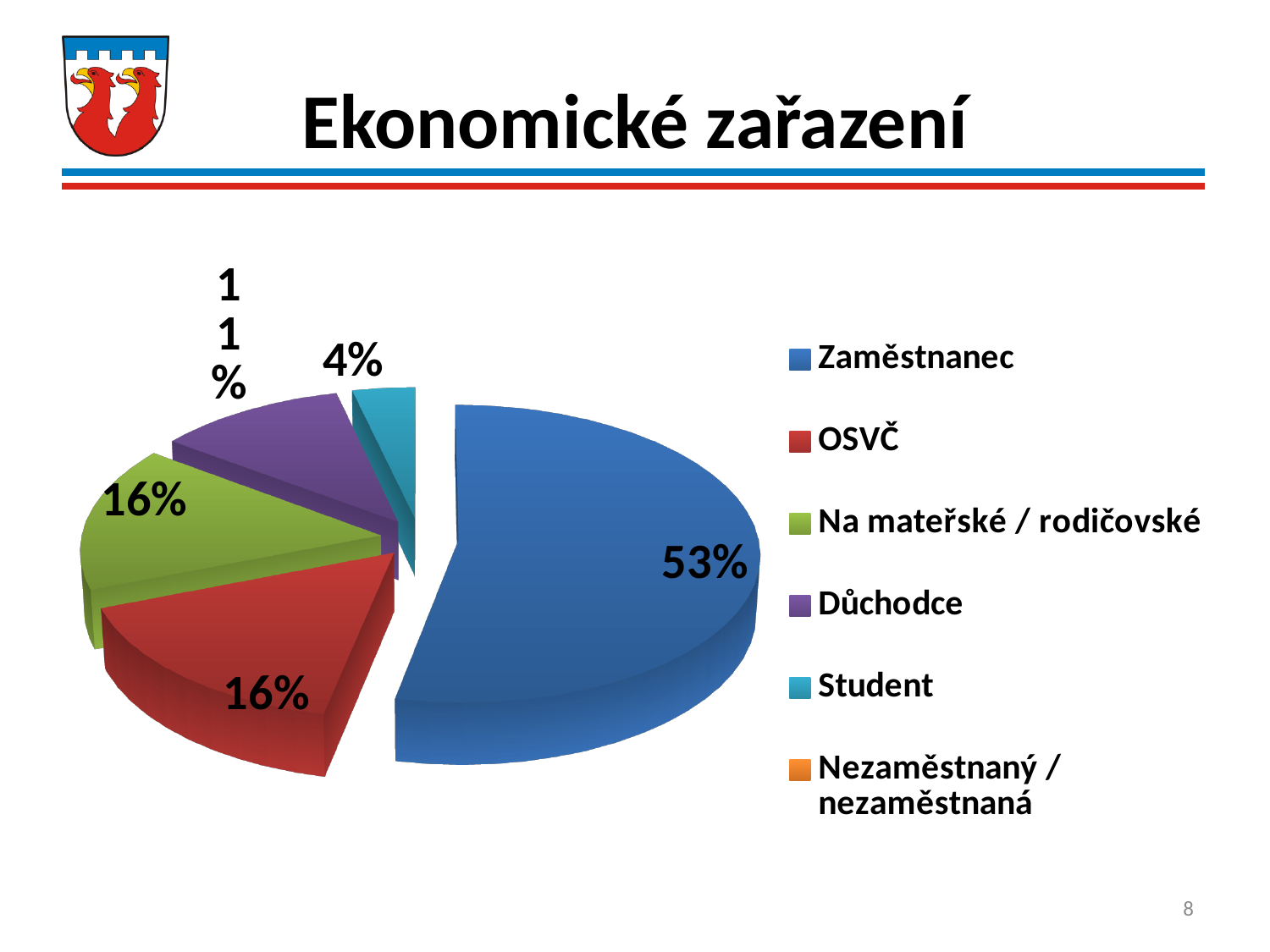
What share of the pie does Zaměstnanec have? 53% What percentage is shown for Na mateřské / rodičovské? 16% What percentage is shown for Student? 4% How many percentage points larger is the Zaměstnanec slice than the Důchodce slice? 42 percentage points What percentage is shown for OSVČ? 16% What is the title of the chart? Ekonomické zařazení Which category has the largest slice of the pie? Zaměstnanec How many categories does the legend list? 6 Which is larger, the slice for Důchodce or the slice for Student? Důchodce What kind of chart is shown on the slide? pie chart What percentage is shown for Důchodce? 11% How many percentage points larger is the Zaměstnanec slice than the Student slice? 49 percentage points